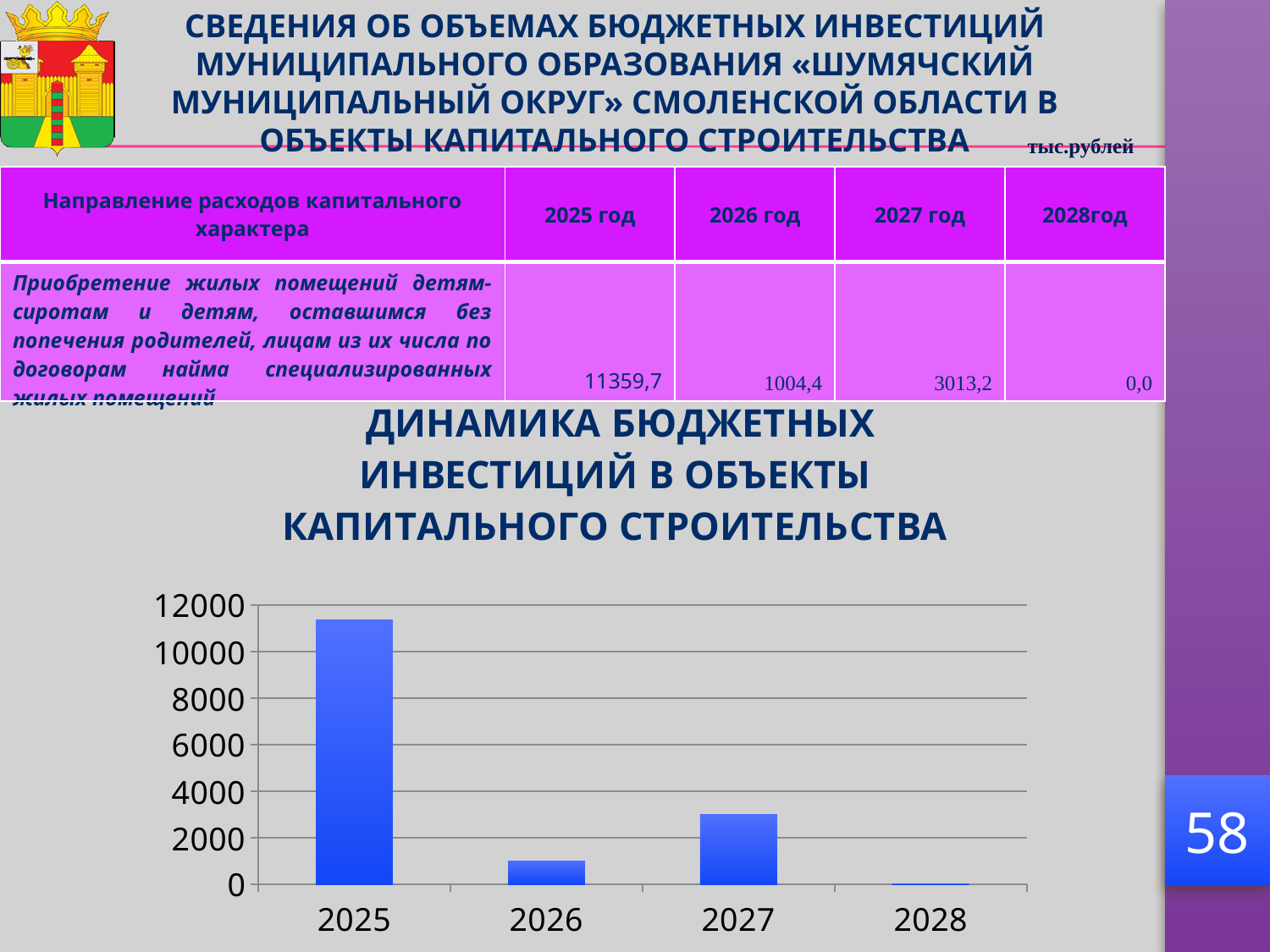
What kind of chart is shown on the slide? bar chart Which year has the lowest bar in the chart? 2028 According to the table on the slide, what is the value for 2028 (thousand rubles)? 0,0 What is the title of the chart? ДИНАМИКА БЮДЖЕТНЫХ ИНВЕСТИЦИЙ В ОБЪЕКТЫ КАПИТАЛЬНОГО СТРОИТЕЛЬСТВА According to the table on the slide, what is the value for 2025 (thousand rubles)? 11359,7 How many years are shown on the x axis of the chart? 4 Is the value for 2027 in the chart greater or less than 2000? greater Which year has the highest bar in the chart? 2025 What is the highest tick value shown on the vertical axis of the chart? 12000 Is the value for 2026 in the chart greater or less than 2000? less Which is larger in the chart, the value for 2026 or the value for 2027? 2027 Is the value for 2025 in the chart greater or less than 10000? greater